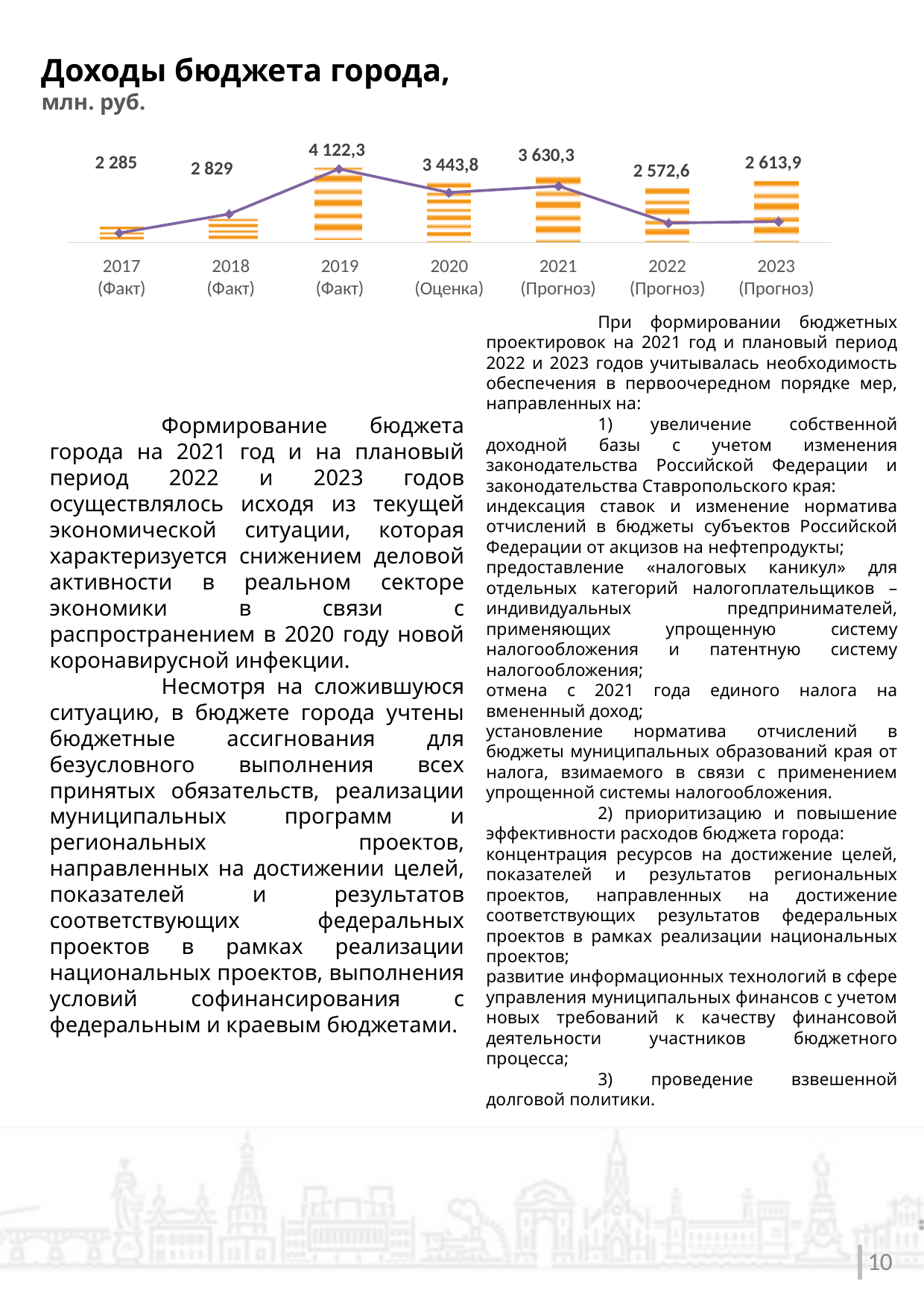
What is the value for 2019 (Факт)? 4 122,3 Which is larger, the value for 2022 (Прогноз) or 2023 (Прогноз)? 2023 (Прогноз) Which year has the highest value? 2019 (Факт) Do the values rise or fall from 2017 to 2019? rise What is the value for 2017 (Факт)? 2 285 What is the difference between the values for 2019 (Факт) and 2017 (Факт)? 1 837,3 Which year has the lowest value? 2017 (Факт) How many years are shown on the chart? 7 What is the difference between the values for 2021 (Прогноз) and 2020 (Оценка)? 186,5 What unit is given in the chart title? млн. руб. What is the value for 2020 (Оценка)? 3 443,8 What is the value for 2022 (Прогноз)? 2 572,6